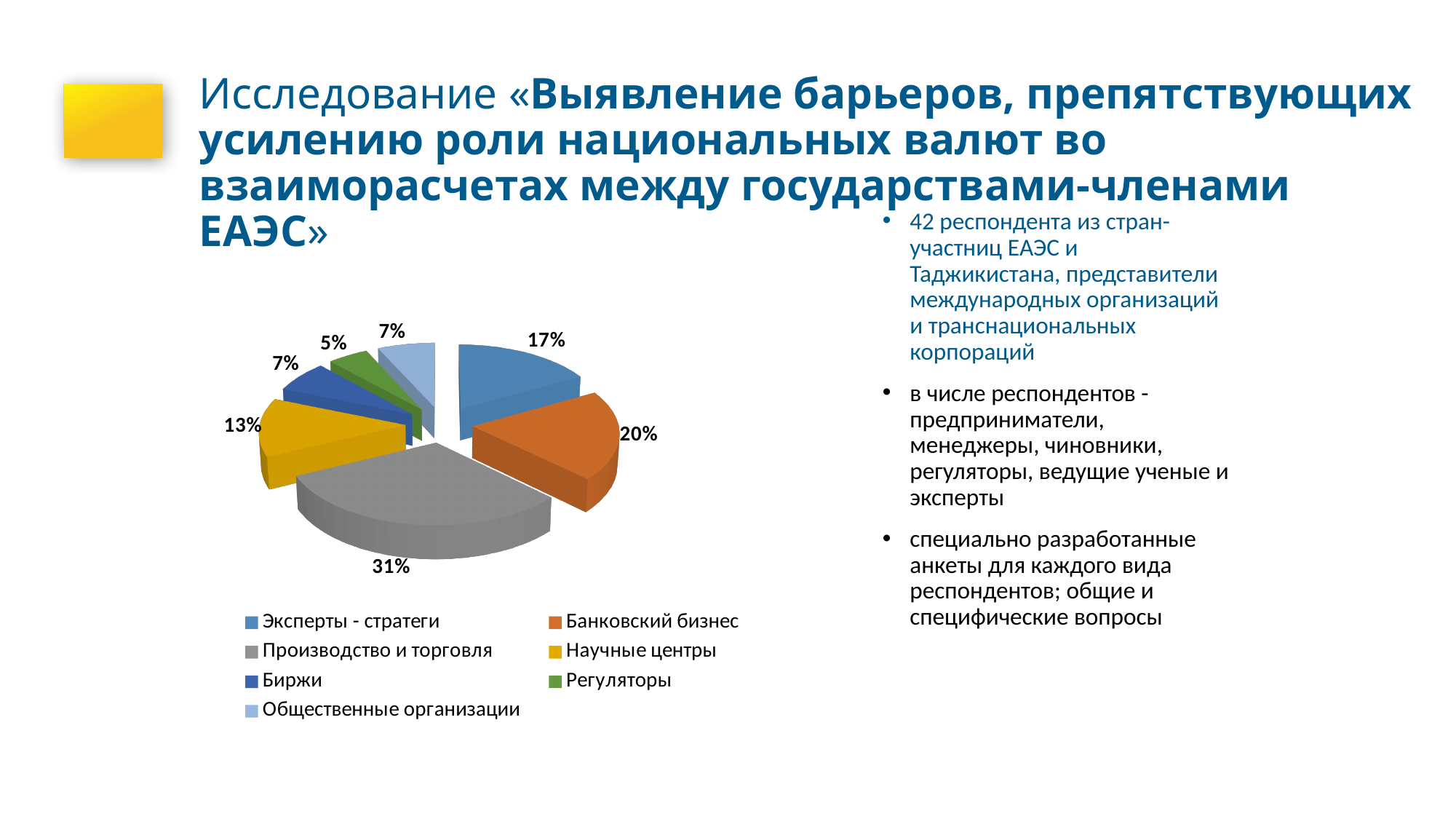
What kind of chart is shown on the slide? pie chart What share of the pie does Регуляторы have? 5% How many categories does the pie chart have? 7 Which is larger, the share of Эксперты - стратеги or the share of Научные центры? Эксперты - стратеги What share of the pie does Производство и торговля have? 31% Which category has the smallest share of the pie? Регуляторы What colour is the slice for Научные центры? yellow What is the difference between the shares of Производство и торговля and Банковский бизнес? 11% What share of the pie does Эксперты - стратеги have? 17% Which category has the largest share of the pie? Производство и торговля